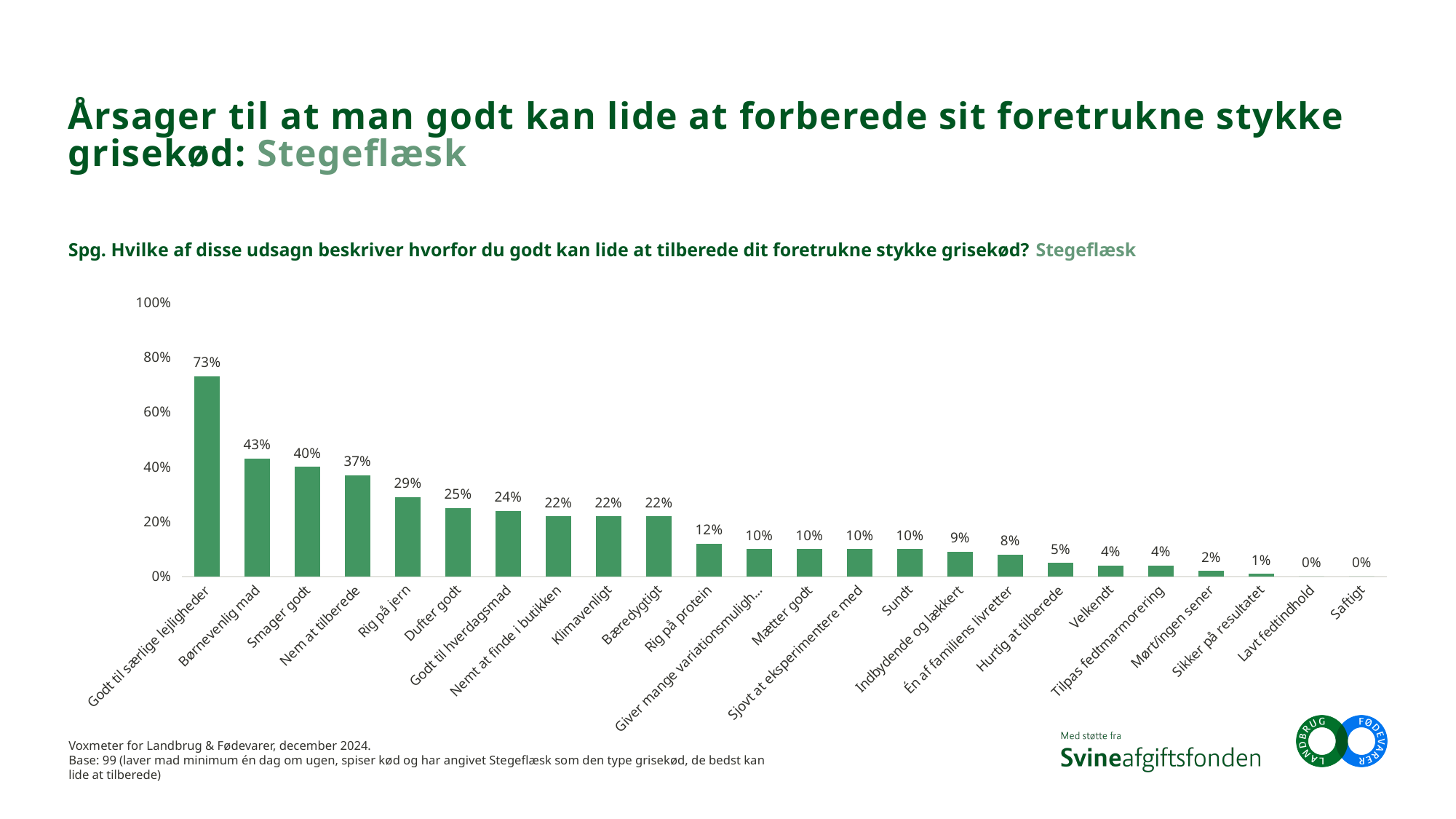
What percentage is shown for "Hurtig at tilberede"? 5% How many categories show a value of 0%? 2 What is the difference between "Godt til særlige lejligheder" and "Nem at tilberede"? 36% How many categories are shown on the x axis of the chart? 24 What is the value shown for "Rig på jern"? 29% What percentage of respondents chose "Godt til særlige lejligheder"? 73% What type of chart is shown on the slide? Bar chart What is the difference between the values for "Børnevenlig mad" and "Smager godt"? 3% Is the value for "Godt til særlige lejligheder" greater or less than 60%? greater Which is larger, the value for "Dufter godt" or the value for "Rig på protein"? Dufter godt Which category has the highest value in the chart? Godt til særlige lejligheder Do the values rise or fall moving from left to right along the x axis? Fall